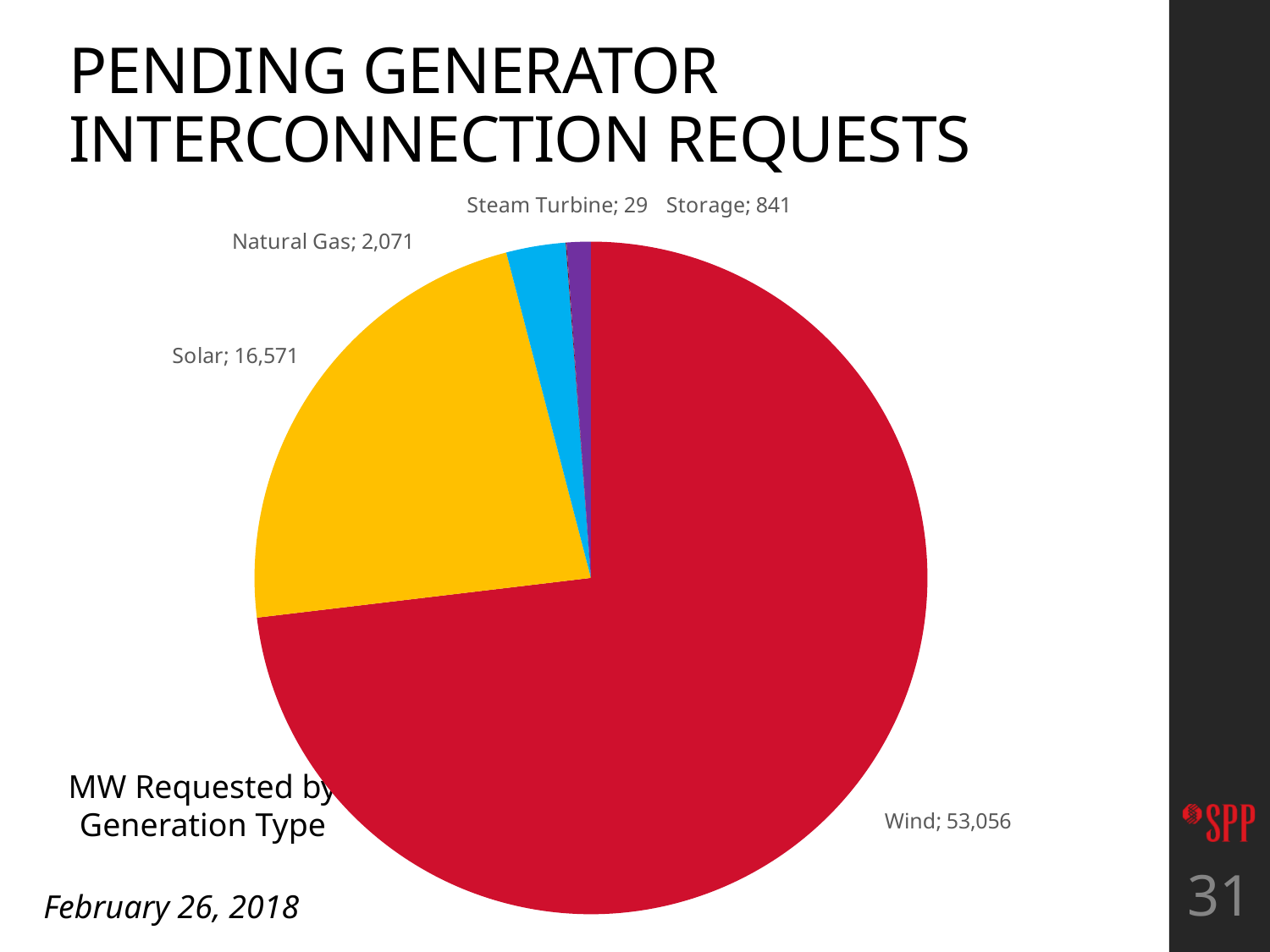
What is the MW value for Wind? 53,056 Which generation type has the largest MW requested? Wind Which generation type has the smallest MW requested? Steam Turbine What kind of chart is shown on the slide? pie chart What is the MW value for Natural Gas? 2,071 What is the MW value for Solar? 16,571 What is the difference in MW requested between Storage and Steam Turbine? 812 What is the title of the pie chart? MW Requested by Generation Type What is the MW value for Storage? 841 Which has more MW requested, Natural Gas or Storage? Natural Gas How many generation types are shown in the pie chart? 5 What is the difference in MW requested between Wind and Solar? 36,485